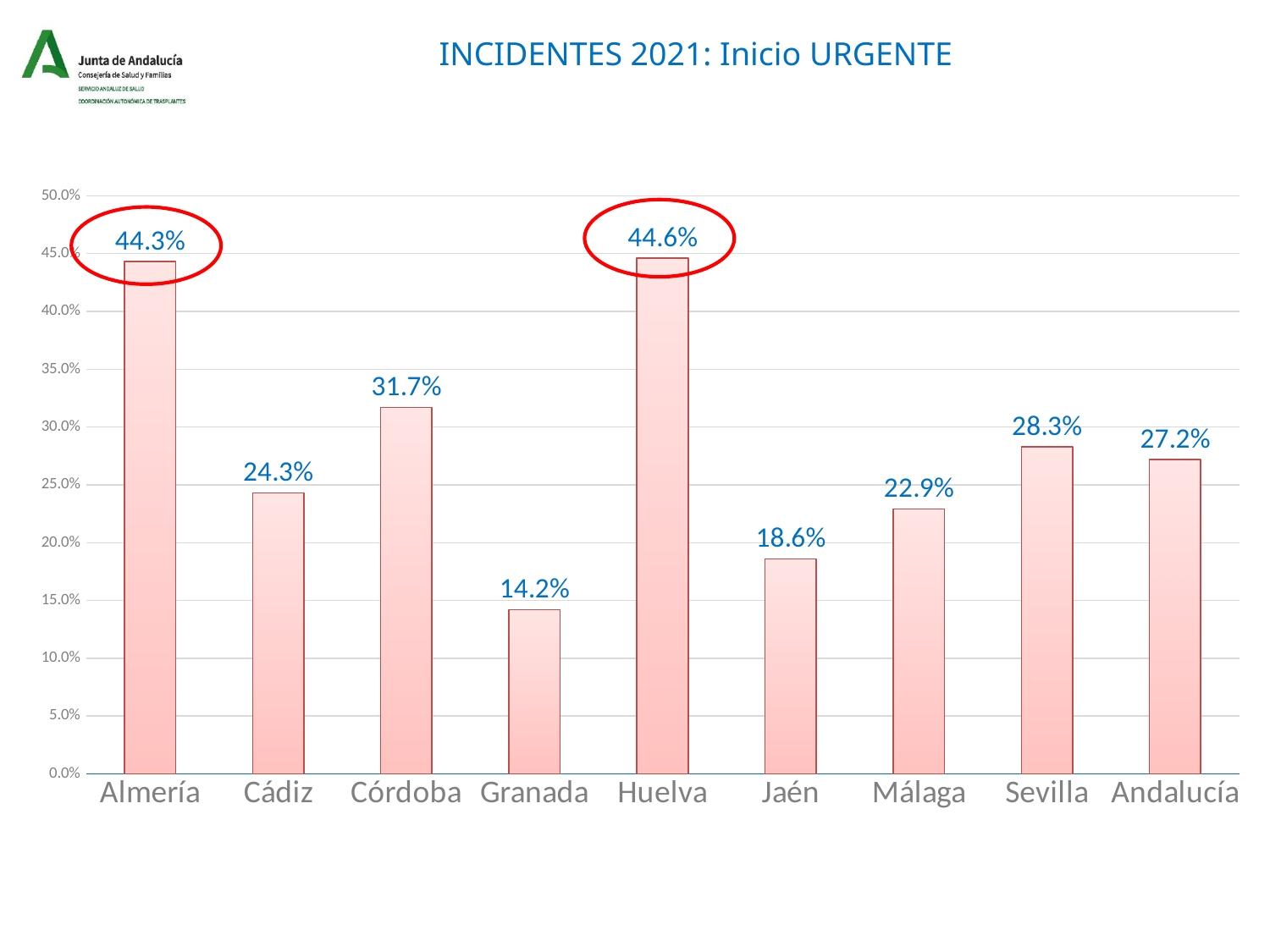
Which category has the lowest value? Granada Which two data labels are circled in red? 44.3% (Almería) and 44.6% (Huelva) What is the difference between the values for Sevilla and Málaga? 5.4% What is the title of the slide? INCIDENTES 2021: Inicio URGENTE How many categories are shown on the x axis? 9 What is the value for Córdoba? 31.7% What is the value for Jaén? 18.6% Is the value for Granada greater or less than 15.0%? less What is the value for Andalucía? 27.2% What kind of chart is shown on the slide? bar chart Which is larger, the value for Cádiz or the value for Málaga? Cádiz What is the difference between the values for Huelva and Almería? 0.3%